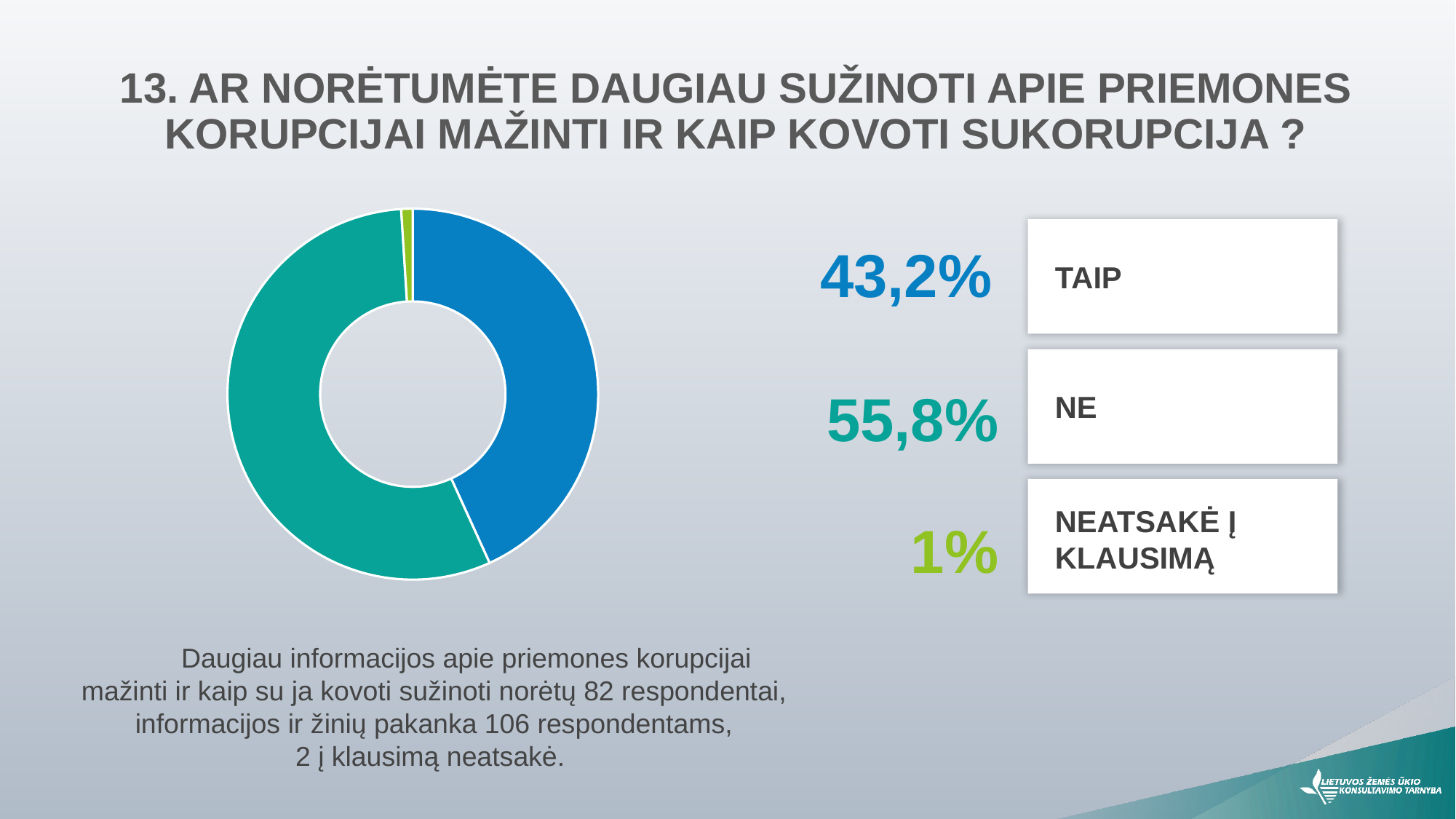
What share of respondents answered TAIP? 43,2% Which is larger, the share for TAIP or the share for NE? NE What kind of chart is shown on the slide? Donut (pie) chart Which answer has the largest share of the chart? NE According to the text below the chart, how many respondents wanted more information about anti-corruption measures? 82 What share of respondents answered NE? 55,8% Which answer has the smallest share of the chart? NEATSAKĖ Į KLAUSIMĄ How many categories does the chart show? 3 What share of respondents did not answer the question (NEATSAKĖ Į KLAUSIMĄ)? 1% What colour is the slice representing NE? Teal (green-blue) Is the share for TAIP greater or less than 50%? less What is the difference in percentage points between the NE and TAIP shares? 12,6